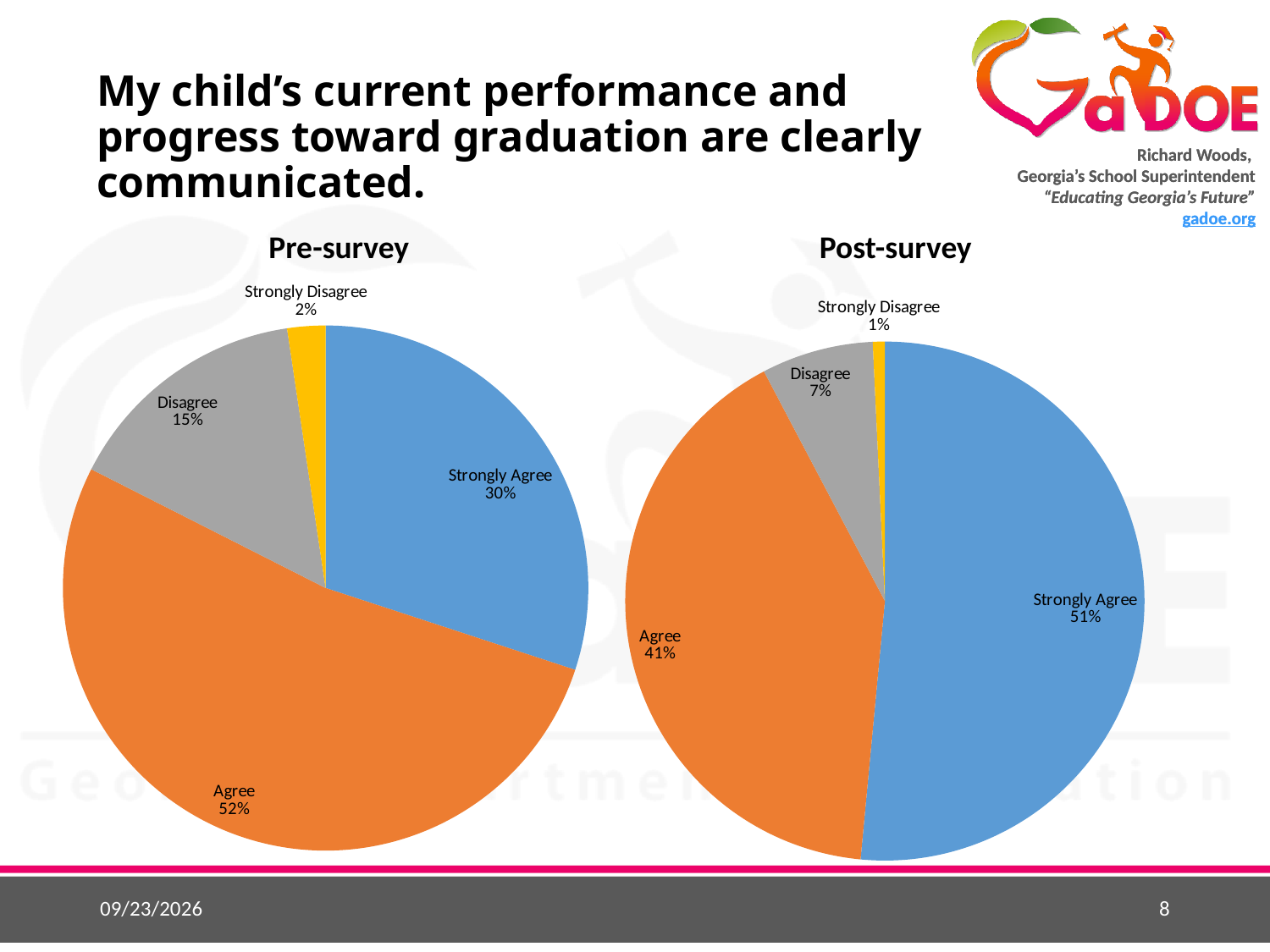
In the Post-survey pie chart, what percentage chose Strongly Disagree? 1% In the Post-survey pie chart, which response has the smallest share? Strongly Disagree How many response categories are shown in the Post-survey pie chart? 4 What is the difference between the Strongly Agree share in the Post-survey chart and the Strongly Agree share in the Pre-survey chart? 21% In the Pre-survey pie chart, which response has the largest share? Agree In the Post-survey pie chart, what percentage of respondents chose Strongly Agree? 51% In the Pre-survey pie chart, what percentage of respondents chose Agree? 52% In the Post-survey pie chart, what colour is the Agree slice? Orange In the Pre-survey pie chart, what percentage chose Disagree? 15% What type of chart is used for the Pre-survey data? Pie chart Which is larger: the Agree share in the Pre-survey chart or the Agree share in the Post-survey chart? Pre-survey In the Pre-survey pie chart, what is the difference between the Agree and Disagree shares? 37%